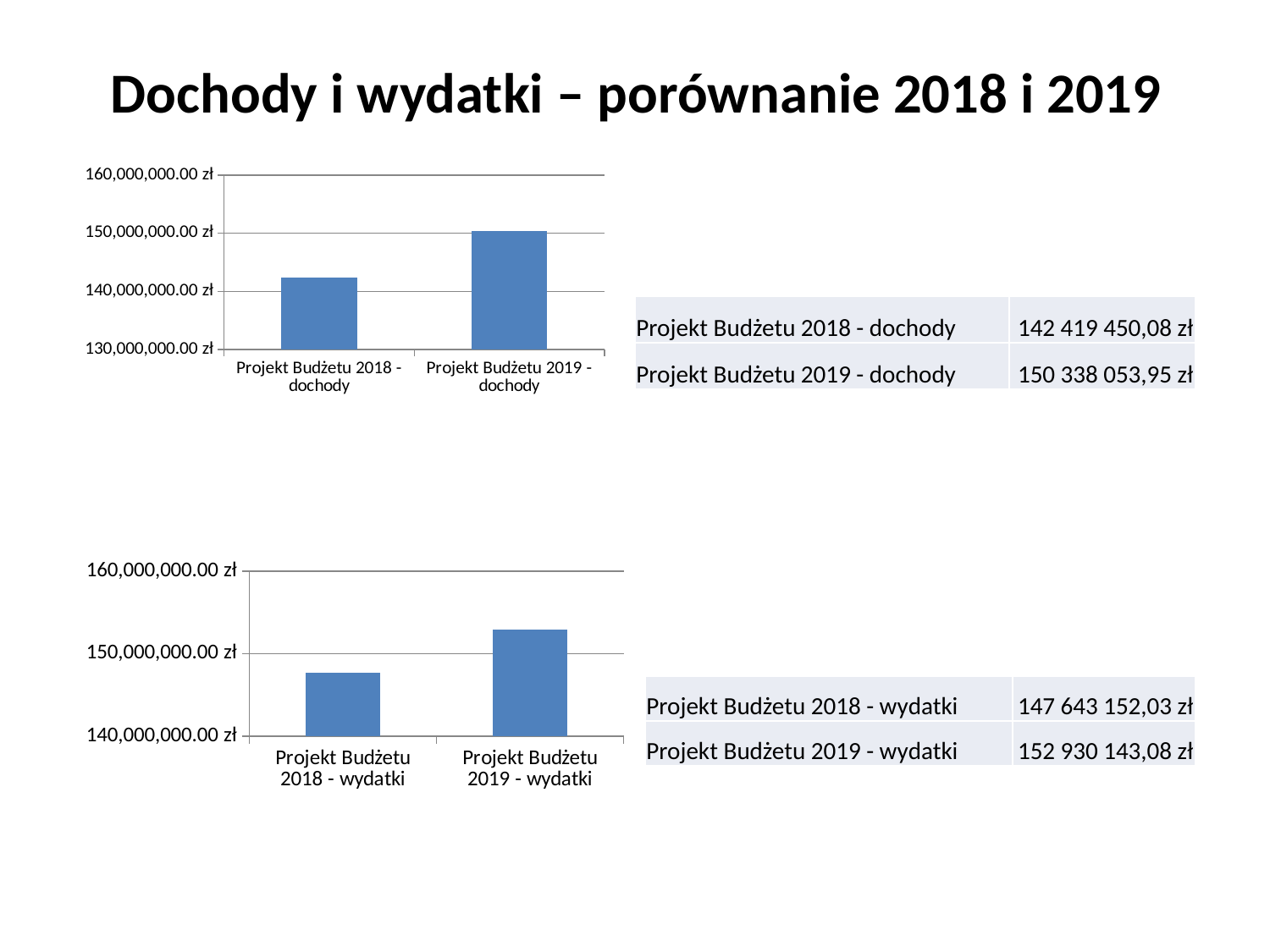
How many bars does the bottom chart (wydatki) show? 2 On the bottom chart (wydatki), which category has the lower value? Projekt Budżetu 2018 - wydatki On the bottom chart (wydatki), what is the value for Projekt Budżetu 2018 - wydatki? 147 643 152,03 zł On the top chart (dochody), what is the difference between the 2019 and 2018 values? 7 918 603,87 zł On the top chart (dochody), which category has the higher value? Projekt Budżetu 2019 - dochody On the top chart (dochody), what is the value for Projekt Budżetu 2018 - dochody? 142 419 450,08 zł On the bottom chart (wydatki), what is the value for Projekt Budżetu 2019 - wydatki? 152 930 143,08 zł On the top chart (dochody), what is the value for Projekt Budżetu 2019 - dochody? 150 338 053,95 zł On the top chart (dochody), is the value for Projekt Budżetu 2018 - dochody greater or less than 140,000,000.00 zł? greater On the bottom chart (wydatki), is the value for Projekt Budżetu 2018 - wydatki greater or less than 150,000,000.00 zł? less What kind of chart is the top chart (dochody)? bar chart On the bottom chart (wydatki), what is the difference between the 2019 and 2018 values? 5 286 991,05 zł